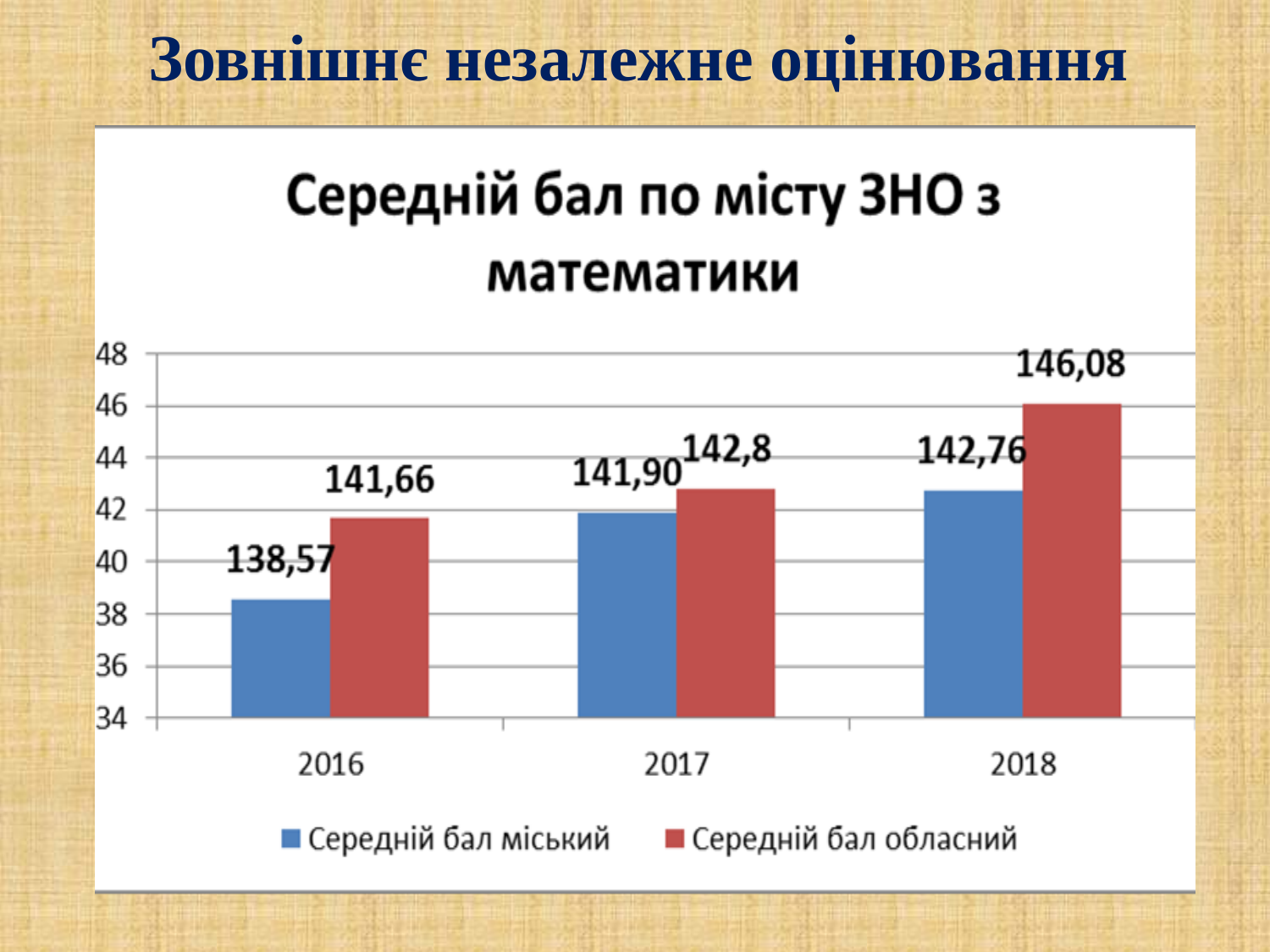
By how much did Середній бал міський increase from 2016 to 2018? 4,19 What is the value for Середній бал обласний in 2018? 146,08 What is the value for Середній бал міський in 2016? 138,57 What is the difference between Середній бал обласний and Середній бал міський in 2018? 3,32 How many series does the legend list? 2 Which is larger in 2016: Середній бал міський or Середній бал обласний? Середній бал обласний In which year is Середній бал міський lowest? 2016 What is the value for Середній бал міський in 2018? 142,76 What is the value for Середній бал обласний in 2017? 142,8 How many years are shown on the x axis? 3 In which year is Середній бал обласний highest? 2018 What kind of chart is shown on the slide? Bar chart